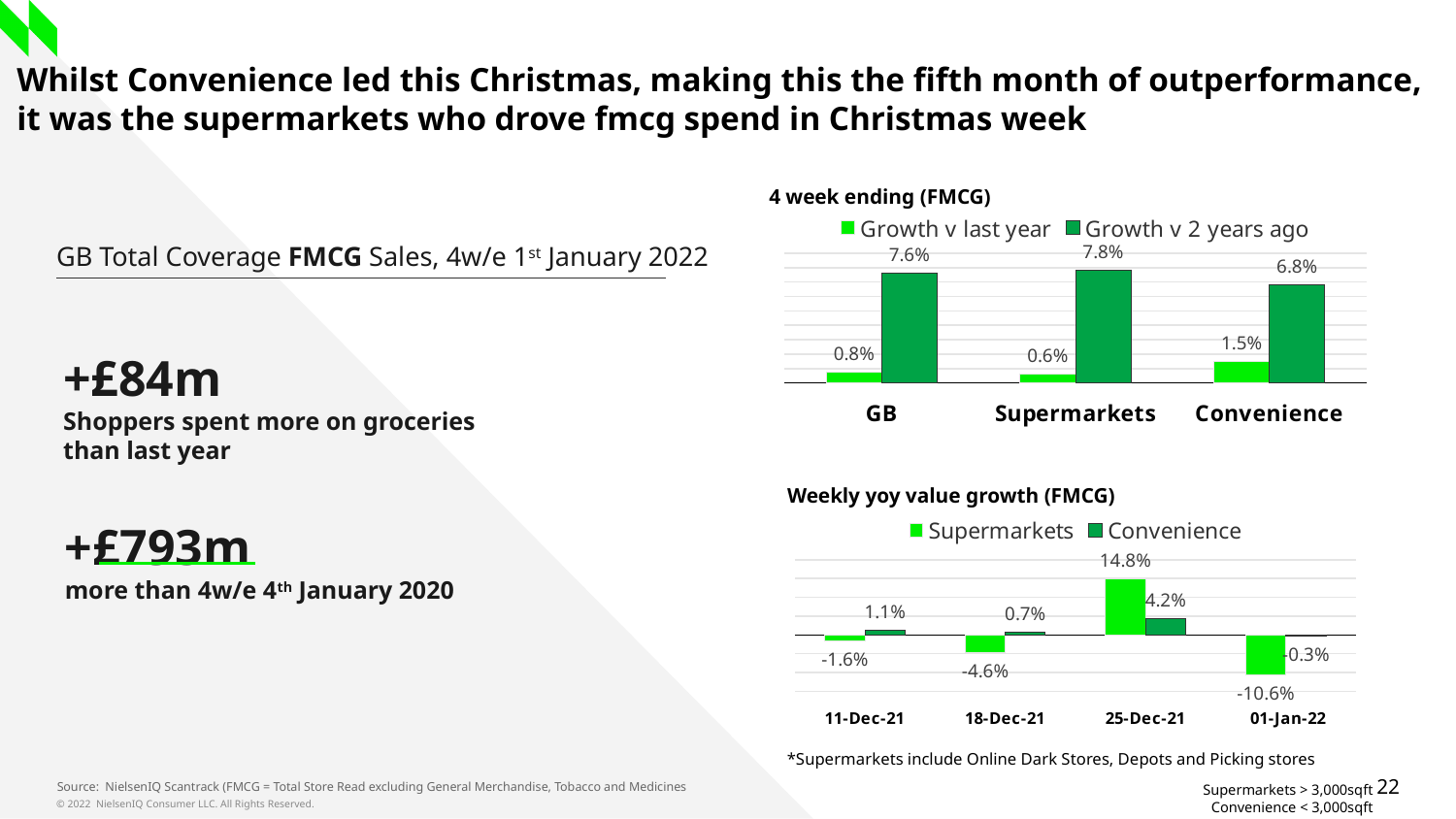
How many weeks are shown on the x axis of the 'Weekly yoy value growth (FMCG)' chart? 4 In the 'Weekly yoy value growth (FMCG)' chart, what is the Convenience value for 01-Jan-22? -0.3% In the 'Weekly yoy value growth (FMCG)' chart, which week has the lowest Supermarkets value? 01-Jan-22 In the '4 week ending (FMCG)' chart, which category has the lowest Growth v last year? Supermarkets In the '4 week ending (FMCG)' chart, what is the Growth v last year value for Convenience? 1.5% In the '4 week ending (FMCG)' chart, what is the difference between Growth v 2 years ago and Growth v last year for GB? 6.8% In the 'Weekly yoy value growth (FMCG)' chart, which is larger for 18-Dec-21: Supermarkets or Convenience? Convenience In the '4 week ending (FMCG)' chart, which category has the highest Growth v 2 years ago? Supermarkets What type of chart is the 'Weekly yoy value growth (FMCG)' chart? Bar chart In the 'Weekly yoy value growth (FMCG)' chart, what is the Supermarkets value for 25-Dec-21? 14.8% How many series does the legend of the '4 week ending (FMCG)' chart list? 2 In the '4 week ending (FMCG)' chart, what is the Growth v 2 years ago value for Supermarkets? 7.8%